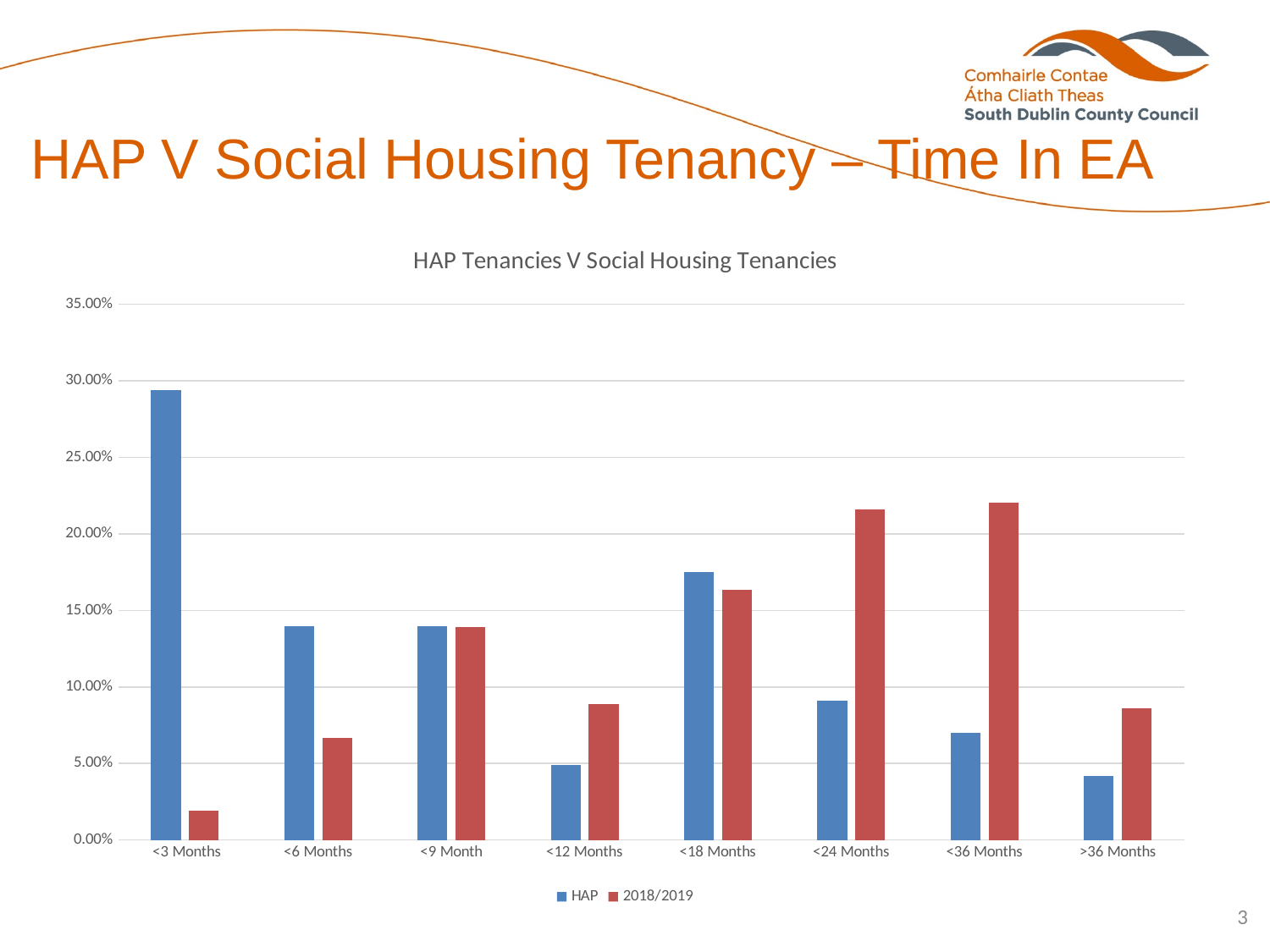
Which category has the highest value for the HAP series? <3 Months Is the HAP value for <12 Months greater or less than 10.00%? less What is the title of the chart? HAP Tenancies V Social Housing Tenancies Is the 2018/2019 value for <3 Months greater or less than 5.00%? less How many categories are shown on the x axis? 8 What kind of chart is shown on the slide? Bar chart For <6 Months, which series has the larger value, HAP or 2018/2019? HAP Is the 2018/2019 value for <24 Months greater or less than 20.00%? greater How many series does the legend list? 2 Which category has the lowest value for the 2018/2019 series? <3 Months For <36 Months, which series has the larger value, HAP or 2018/2019? 2018/2019